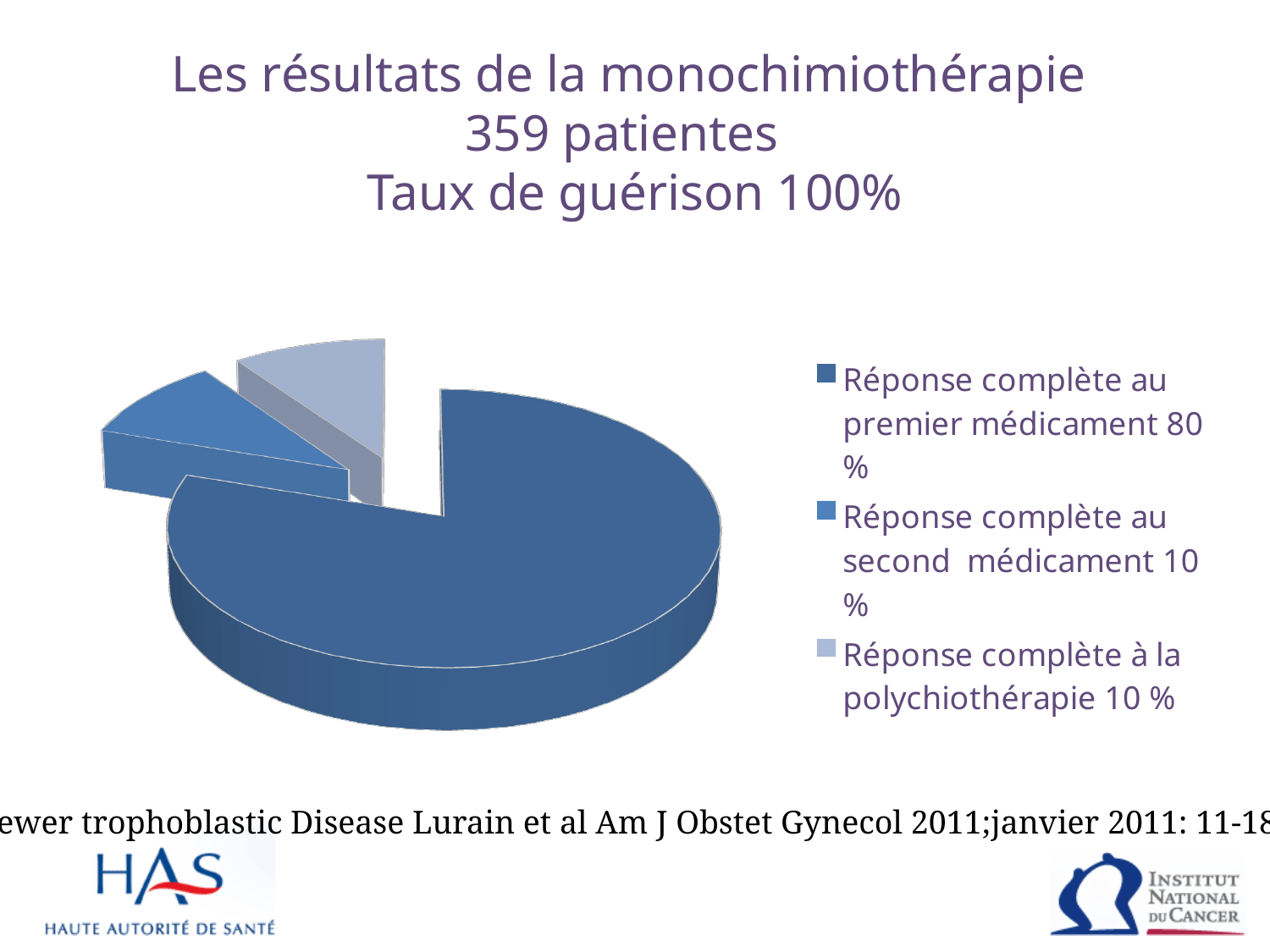
Which category has the largest slice of the pie chart? Réponse complète au premier médicament What is the value for 'Réponse complète au second médicament'? 10 % What is the total of the three shares shown in the legend? 100 % How many entries does the legend of the pie chart list? 3 What share of the pie does 'Réponse complète au premier médicament' represent? 80 % How many slices does the pie chart have? 3 What is the value for 'Réponse complète à la polychiothérapie'? 10 % Which is larger: the share for 'Réponse complète au premier médicament' or the share for 'Réponse complète à la polychiothérapie'? Réponse complète au premier médicament How many patients does the slide title say the results are based on? 359 patientes What is the difference between the share for 'Réponse complète au premier médicament' and the share for 'Réponse complète au second médicament'? 70 % What colour is the largest slice of the pie chart? dark blue What kind of chart is shown on the slide? pie chart